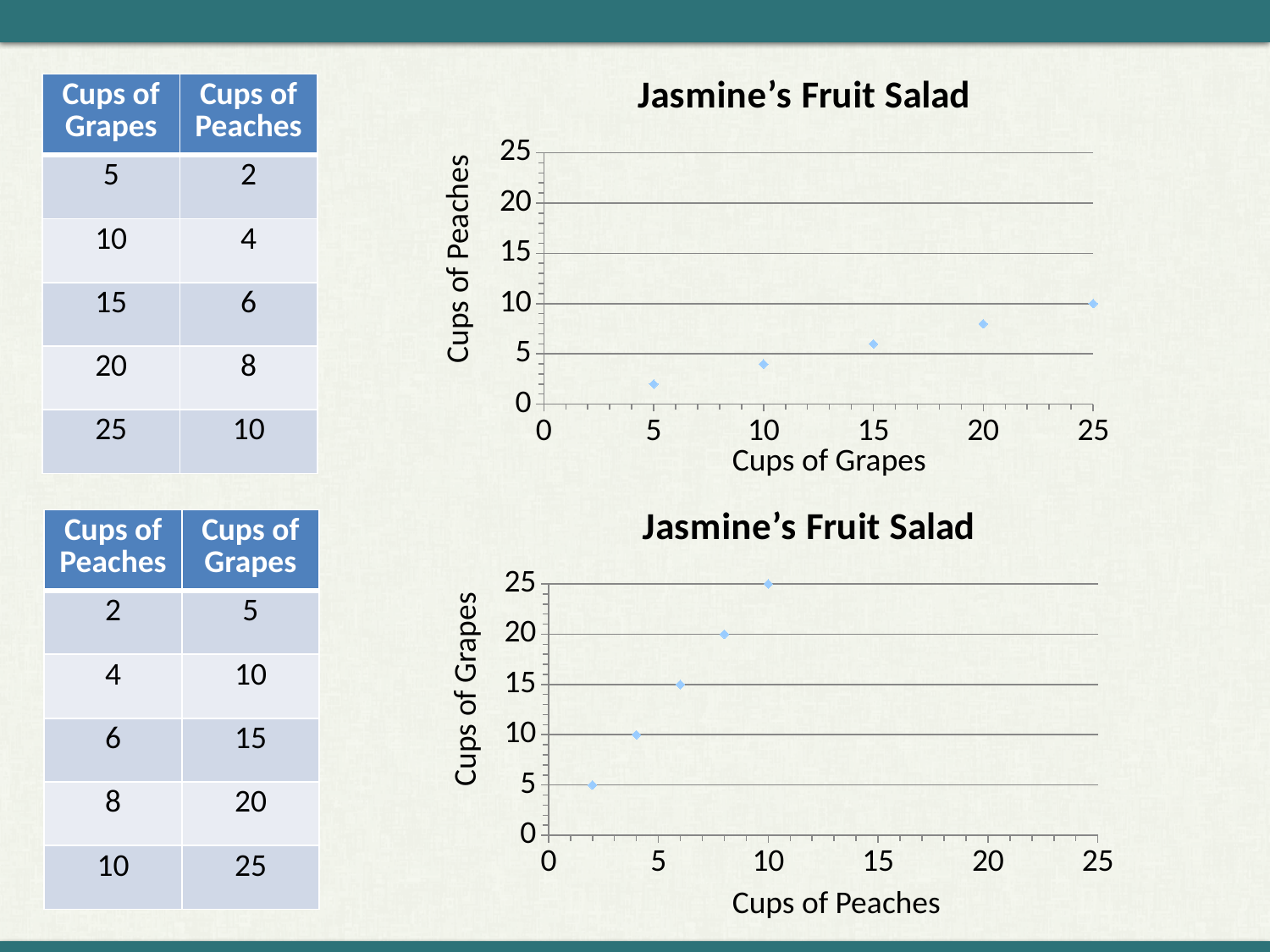
On the bottom chart, which has more Cups of Grapes: 4 Cups of Peaches or 8 Cups of Peaches? 8 Cups of Peaches On the bottom chart, at which Cups of Peaches value is Cups of Grapes lowest? 2 On the bottom chart, is the Cups of Grapes value at 8 Cups of Peaches greater or less than 15? greater On the top chart, is the Cups of Peaches value at 15 Cups of Grapes greater or less than 10? less On the bottom chart, how many Cups of Grapes correspond to 10 Cups of Peaches? 25 What kind of chart is the top chart on the slide? scatter chart On the top chart, how many Cups of Peaches correspond to 25 Cups of Grapes? 10 On the top chart, at which Cups of Grapes value is Cups of Peaches highest? 25 How many data points are plotted on the top chart? 5 On the top chart, do the values rise or fall as Cups of Grapes increases? rise What is the x-axis label of the bottom chart? Cups of Peaches On the top chart, what is the difference in Cups of Peaches between 25 Cups of Grapes and 5 Cups of Grapes? 8